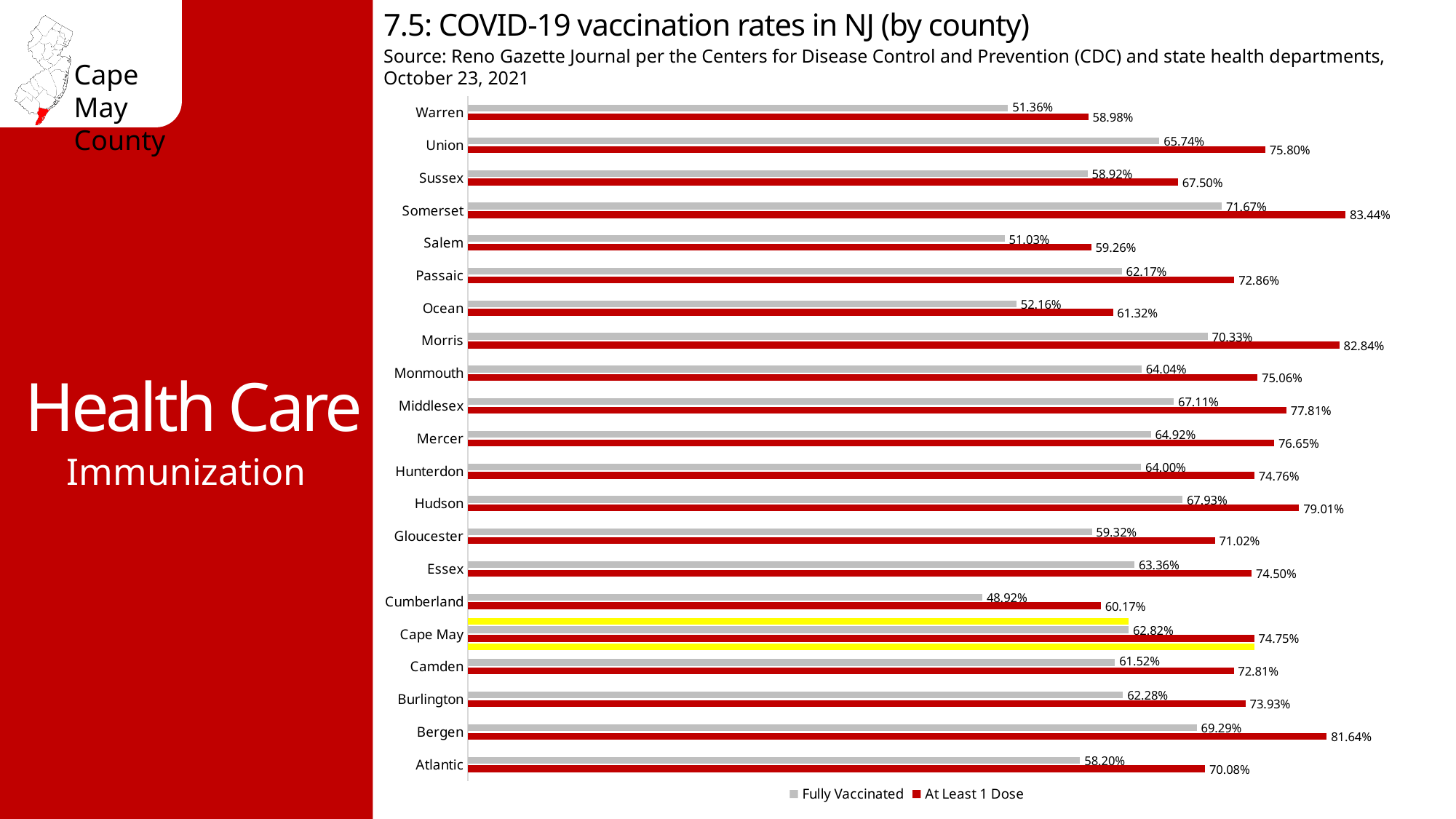
What is the At Least 1 Dose rate for Somerset? 83.44% Which county has the lowest Fully Vaccinated rate? Cumberland What kind of chart is shown on the slide? Bar chart What is the Fully Vaccinated rate for Cape May? 62.82% Which county's bars are highlighted in yellow? Cape May Which county has the lowest At Least 1 Dose rate? Warren What is the difference between the At Least 1 Dose rate and the Fully Vaccinated rate for Cape May? 11.93% What is the Fully Vaccinated rate for Cumberland? 48.92% Which county has the higher At Least 1 Dose rate, Bergen or Hudson? Bergen How many series does the legend list? 2 Which county has the highest Fully Vaccinated rate? Somerset How many counties are shown in the chart? 21